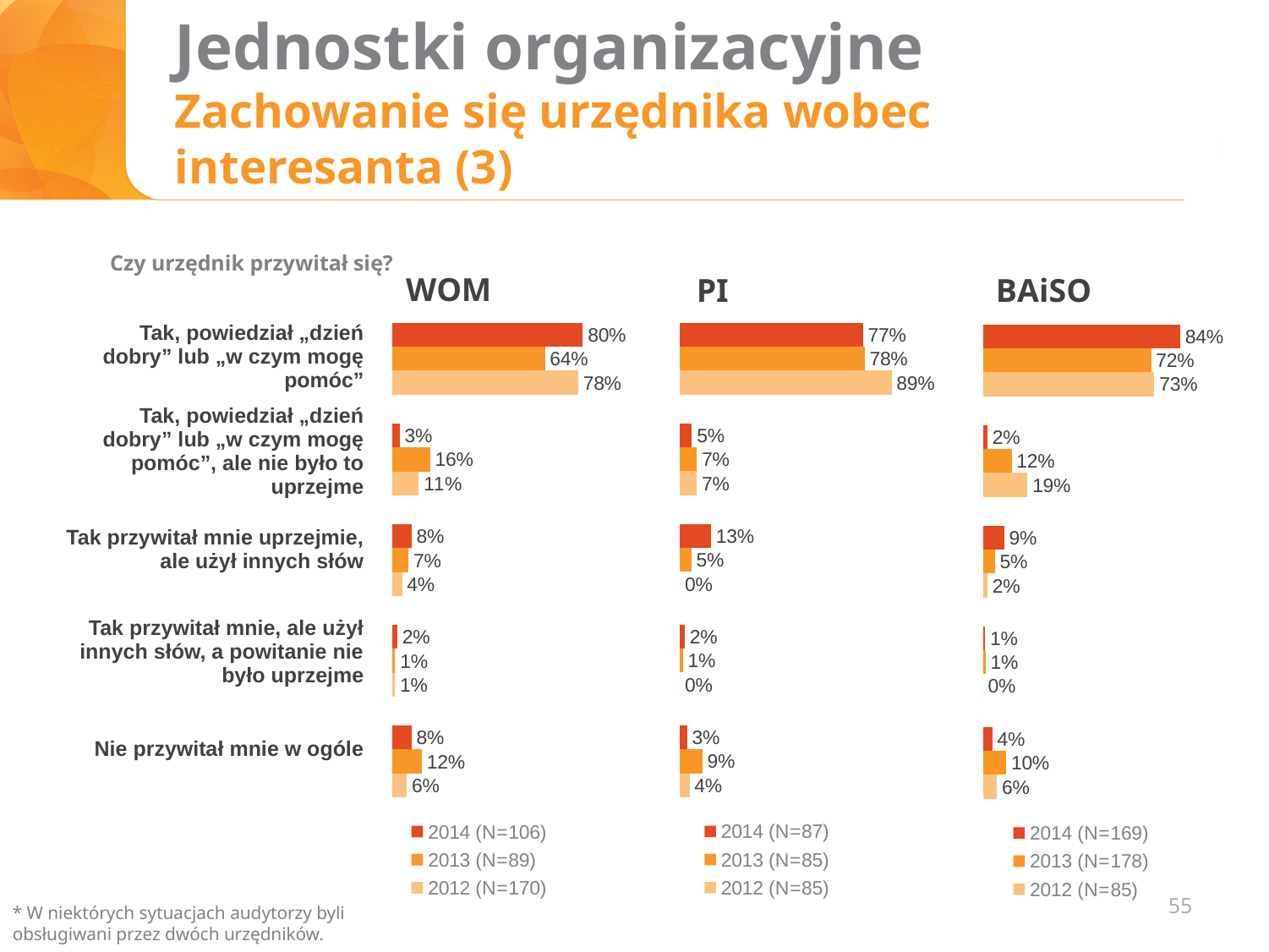
How many series does the legend of the PI chart list? 3 In the PI chart, what is the 2014 value for "Tak przywitał mnie uprzejmie, ale użył innych słów"? 13% How many response categories are shown in each chart? 5 What type of chart is used for WOM, PI and BAiSO? Bar chart In the WOM chart, which year has the lowest value for "Tak, powiedział „dzień dobry” lub „w czym mogę pomóc”"? 2013 In the BAiSO chart, what is the difference between the 2012 and 2014 values for "Tak, powiedział „dzień dobry” lub „w czym mogę pomóc”, ale nie było to uprzejme"? 17% In the PI chart legend, what is the sample size (N) for 2014? N=87 In the WOM chart, which is larger for "Nie przywitał mnie w ogóle": the 2013 value or the 2012 value? 2013 In the BAiSO chart, what is the 2013 value for "Nie przywitał mnie w ogóle"? 10% In the BAiSO chart, which year has the highest value for "Tak, powiedział „dzień dobry” lub „w czym mogę pomóc”"? 2014 In the WOM chart, what is the 2014 value for "Tak, powiedział „dzień dobry” lub „w czym mogę pomóc”"? 80% In the PI chart, what is the 2012 value for "Tak, powiedział „dzień dobry” lub „w czym mogę pomóc”"? 89%